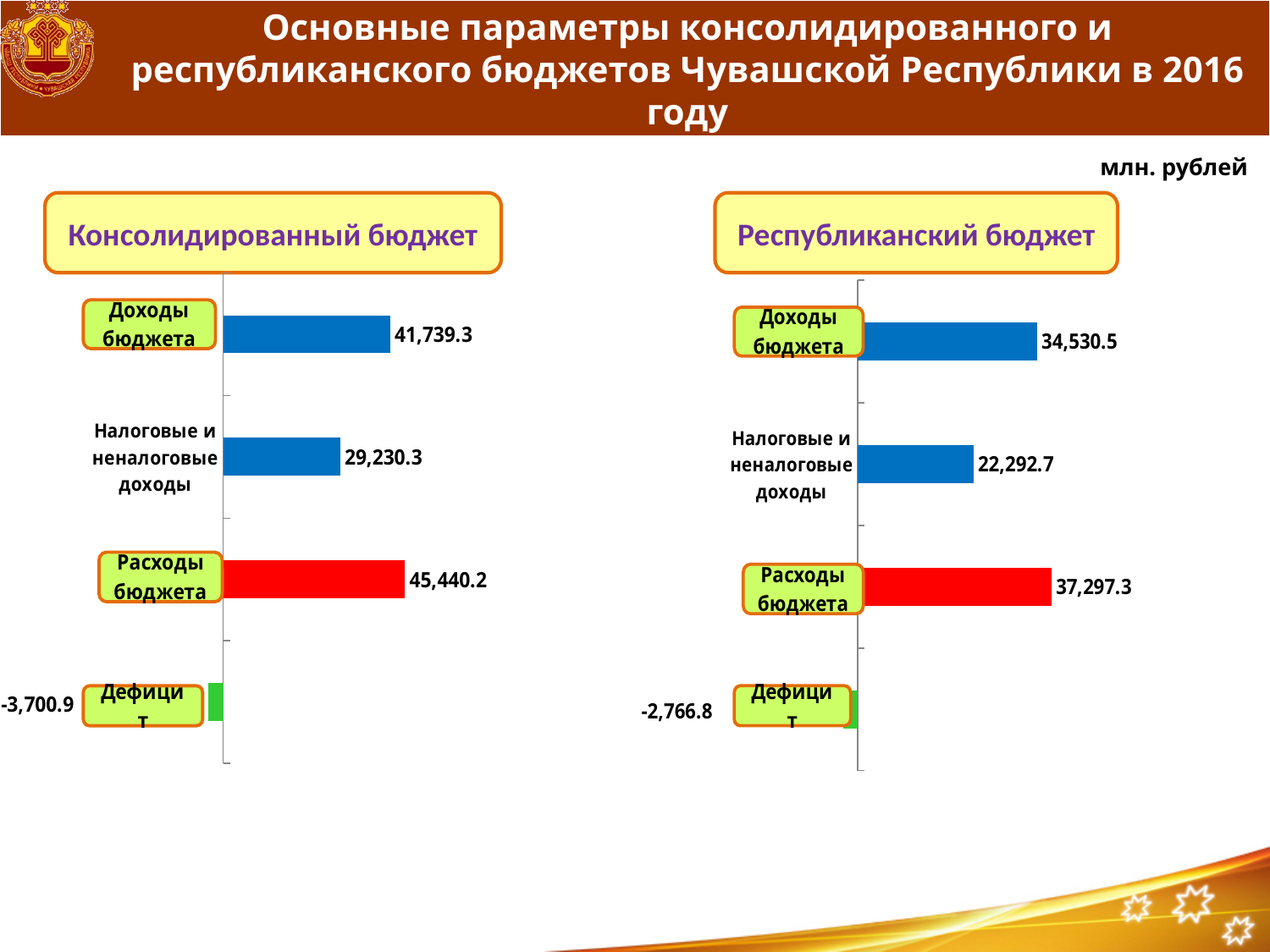
In the Республиканский бюджет chart, what is the difference between Доходы бюджета and Налоговые и неналоговые доходы? 12,237.8 In the Консолидированный бюджет chart, what is the value for Расходы бюджета? 45,440.2 In the Консолидированный бюджет chart, what is the difference between Расходы бюджета and Доходы бюджета? 3,700.9 In the Республиканский бюджет chart, what is the value for Налоговые и неналоговые доходы? 22,292.7 Which is larger: Доходы бюджета in the Консолидированный бюджет chart or Доходы бюджета in the Республиканский бюджет chart? Консолидированный бюджет What unit of measurement is stated on the slide for the chart values? млн. рублей In the Консолидированный бюджет chart, which category has the highest value? Расходы бюджета How many categories are shown in the Республиканский бюджет chart? 4 In the Республиканский бюджет chart, which category has the lowest value? Дефицит In the Республиканский бюджет chart, what is the value for Дефицит? -2,766.8 In the Консолидированный бюджет chart, what is the value for Доходы бюджета? 41,739.3 What type of chart is the Консолидированный бюджет chart? Bar chart